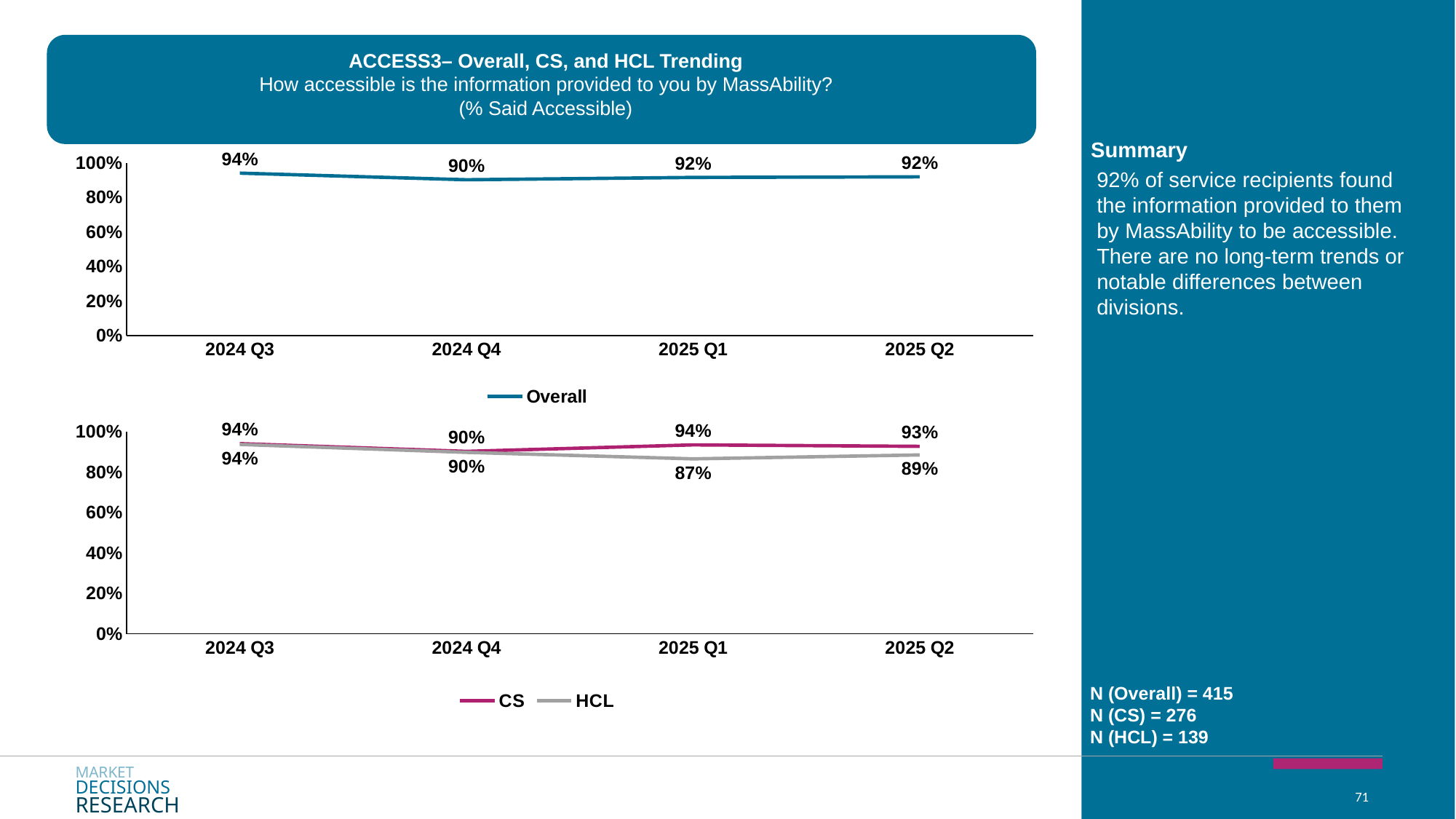
In the bottom chart, what is the HCL value for 2025 Q2? 89% In the top chart (Overall), how many quarters are plotted? 4 In the bottom chart, what is the CS value for 2025 Q1? 94% What type of chart is the top chart? Line chart In the bottom chart, which quarter has the lowest HCL value? 2025 Q1 In the top chart (Overall), which quarter has the lowest value? 2024 Q4 In the bottom chart, how many series does the legend list? 2 In the top chart (Overall), what is the difference between the 2024 Q3 value and the 2024 Q4 value? 4% In the top chart (Overall), what is the value for 2024 Q3? 94% In the bottom chart, which series has the higher value in 2025 Q1, CS or HCL? CS In the bottom chart, what is the difference between the CS and HCL values in 2025 Q1? 7% In the top chart (Overall), what is the value for 2024 Q4? 90%